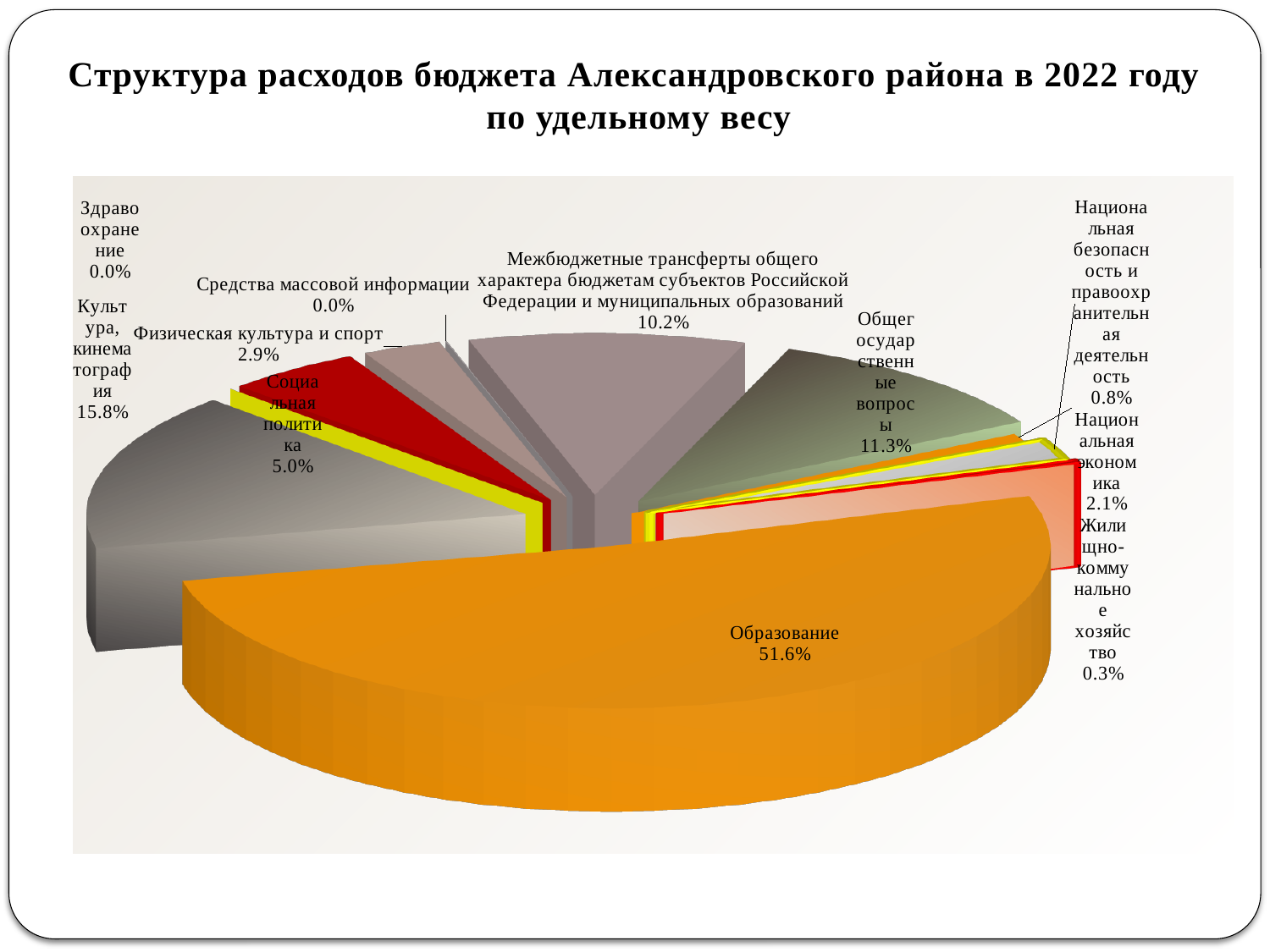
How many expenditure categories are labelled on the pie chart? 11 What is the difference between the shares of Образование and Культура, кинематография? 35.8% What is the share for Национальная безопасность и правоохранительная деятельность? 0.8% What is the share for Общегосударственные вопросы? 11.3% What is the share for Социальная политика? 5.0% Which category has the largest share of the budget expenditure? Образование Which is larger: the share for Общегосударственные вопросы or the share for Межбюджетные трансферты общего характера? Общегосударственные вопросы What kind of chart is shown on the slide? pie chart Which two categories have a share of 0.0%? Здравоохранение and Средства массовой информации What is the title of the chart? Структура расходов бюджета Александровского района в 2022 году по удельному весу What share of the budget expenditure goes to Образование? 51.6% What is the share for Культура, кинематография? 15.8%